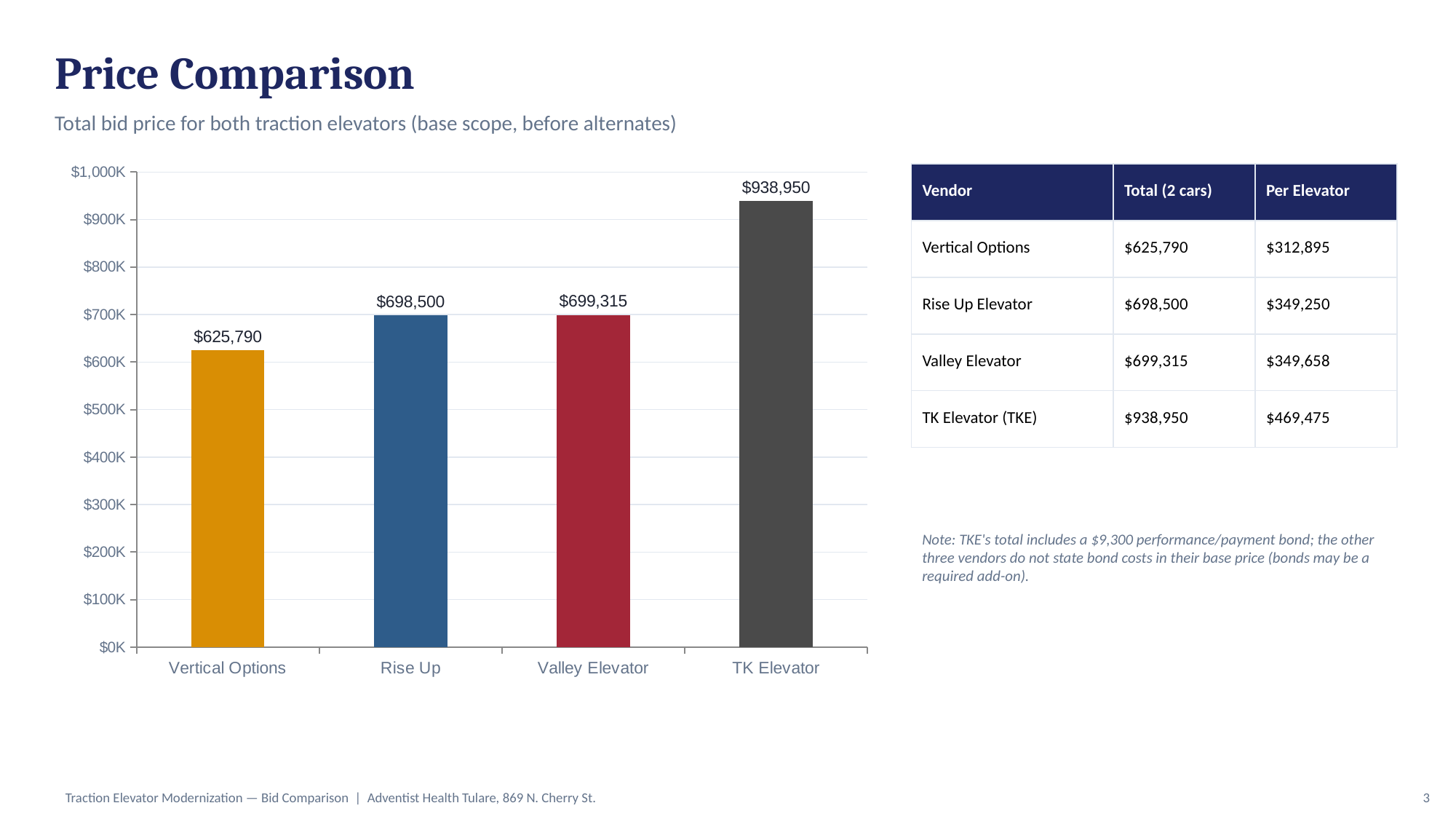
What is the total bid price shown for TK Elevator? $938,950 Is the value for Vertical Options greater or less than $600K? greater What is the difference between the Valley Elevator bid and the Rise Up bid? $815 What is the difference between the TK Elevator bid and the Vertical Options bid? $313,160 What kind of chart is shown on the slide? bar chart What is the total bid price shown for Rise Up? $698,500 What is the total bid price shown for Vertical Options? $625,790 What is the total bid price shown for Valley Elevator? $699,315 Which is larger, the bid from TK Elevator or the bid from Valley Elevator? TK Elevator Which vendor has the lowest total bid price? Vertical Options How many vendors are shown in the chart? 4 Which vendor has the highest total bid price? TK Elevator